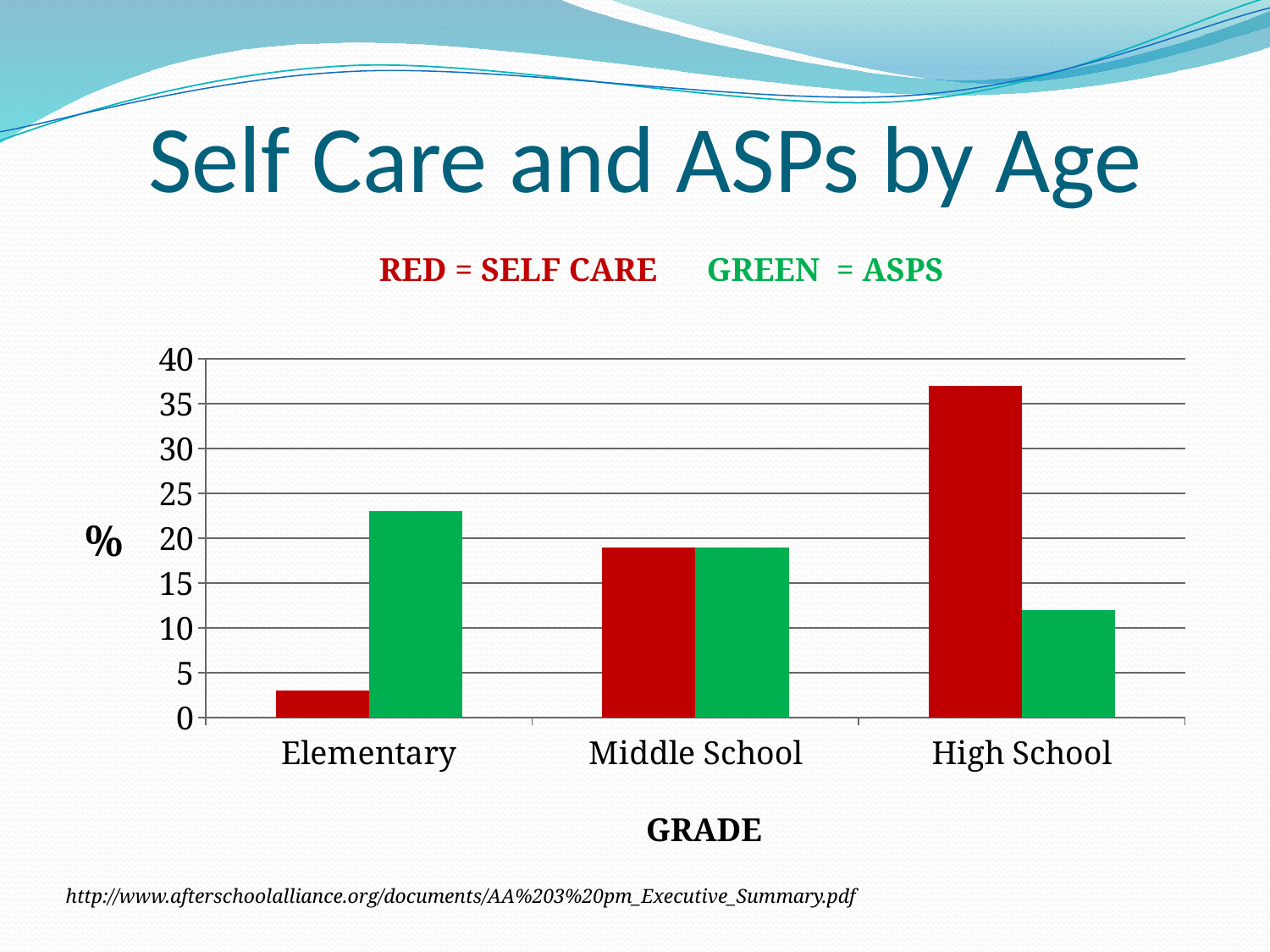
According to the key above the chart, what does the green colour represent? ASPs How many grade categories are shown on the x axis? 3 Does the Self Care (red) value rise or fall from Elementary to High School? rise Is the Self Care (red) value for Elementary greater or less than 5? less Is the Self Care (red) value for High School greater or less than 35? greater Which grade has the highest ASPs (green) value? Elementary According to the key above the chart, what does the red colour represent? Self Care For Elementary, which is larger: the Self Care (red) value or the ASPs (green) value? ASPs (green) What kind of chart is shown on the slide? bar chart Which grade has the lowest ASPs (green) value? High School Which grade has the highest Self Care (red) value? High School Which grade has the lowest Self Care (red) value? Elementary